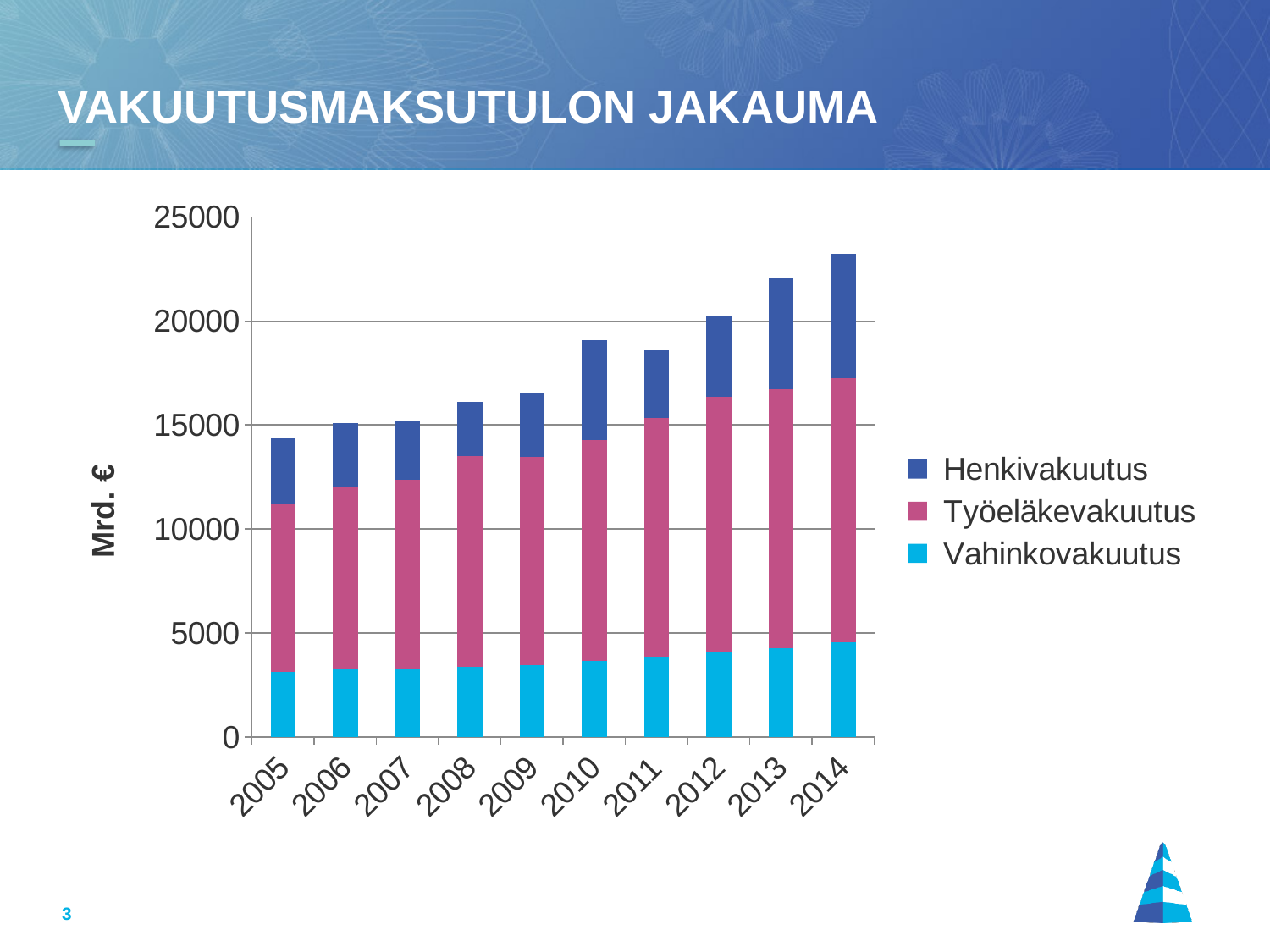
Which year has the highest total bar in the chart? 2014 Is the Vahinkovakuutus value for 2014 greater or less than 5000? less How many years are shown on the x axis of the chart? 10 Is the total bar for 2005 greater or less than 15000? less Is the total bar for 2010 greater or less than 15000? greater Which year has the larger total bar, 2012 or 2011? 2012 How many series does the chart's legend list? 3 Which year has the lowest total bar in the chart? 2005 Do the total bars generally rise or fall from 2005 to 2014? rise What kind of chart is shown on the slide? Stacked bar chart What is the label on the y axis of the chart? Mrd. €